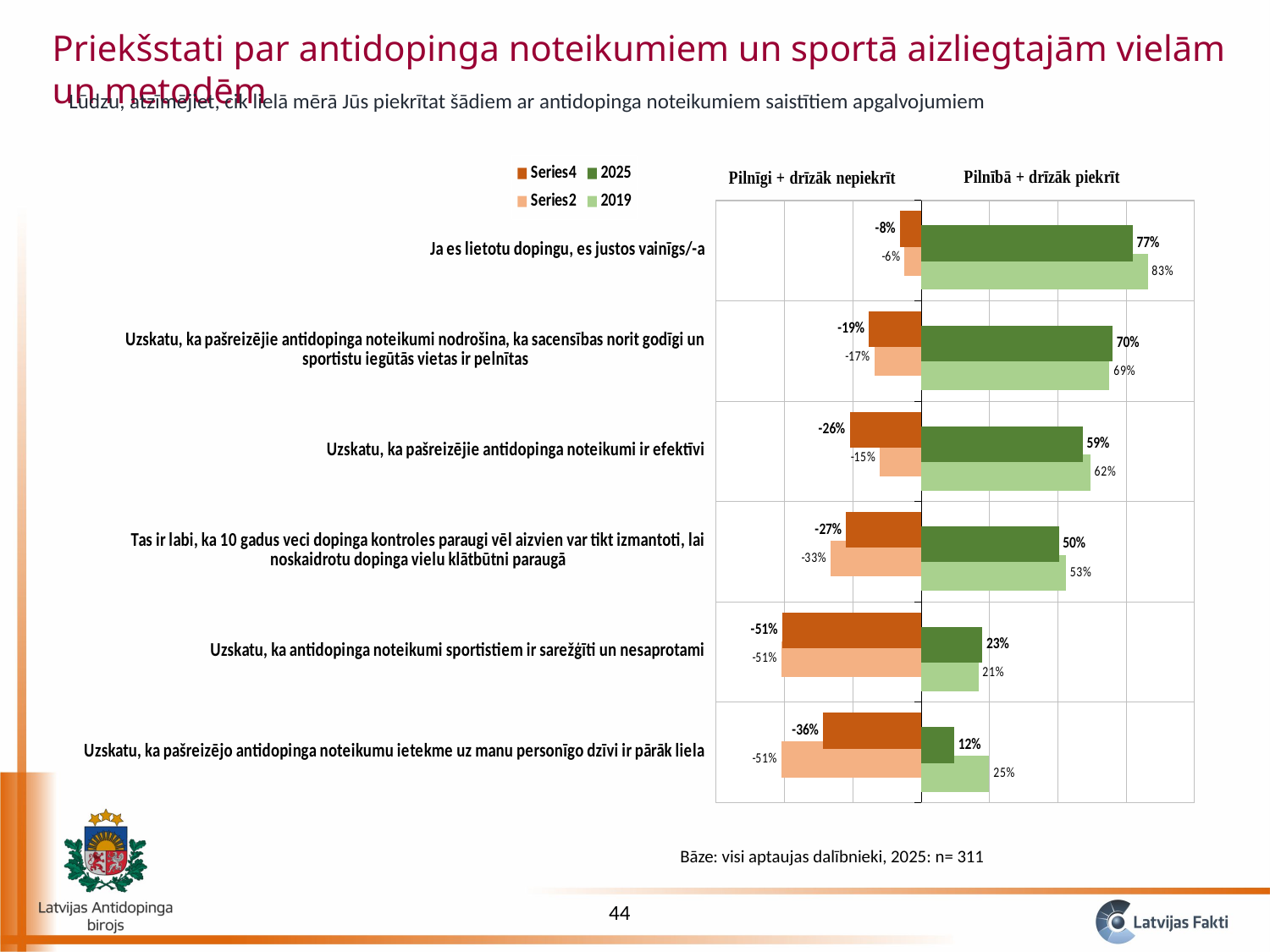
How many series does the legend list? 4 What is the base (sample size) stated below the chart for 2025? n= 311 Which category has the lowest 2025 value? Uzskatu, ka pašreizējo antidopinga noteikumu ietekme uz manu personīgo dzīvi ir pārāk liela What is the 2025 value for "Ja es lietotu dopingu, es justos vainīgs/-a"? 77% What is the 2019 value for "Uzskatu, ka pašreizējie antidopinga noteikumi ir efektīvi"? 62% How many categories (statements) are shown in the chart? 6 What is the difference between the 2019 and 2025 values for "Ja es lietotu dopingu, es justos vainīgs/-a"? 6% Which category has the highest 2025 value? Ja es lietotu dopingu, es justos vainīgs/-a Which is larger for "Uzskatu, ka pašreizējo antidopinga noteikumu ietekme uz manu personīgo dzīvi ir pārāk liela": the 2025 value or the 2019 value? 2019 What kind of chart is shown on the slide? Bar chart What is the Series2 value for "Tas ir labi, ka 10 gadus veci dopinga kontroles paraugi vēl aizvien var tikt izmantoti, lai noskaidrotu dopinga vielu klātbūtni paraugā"? -33% What is the Series4 value for "Uzskatu, ka antidopinga noteikumi sportistiem ir sarežģīti un nesaprotami"? -51%